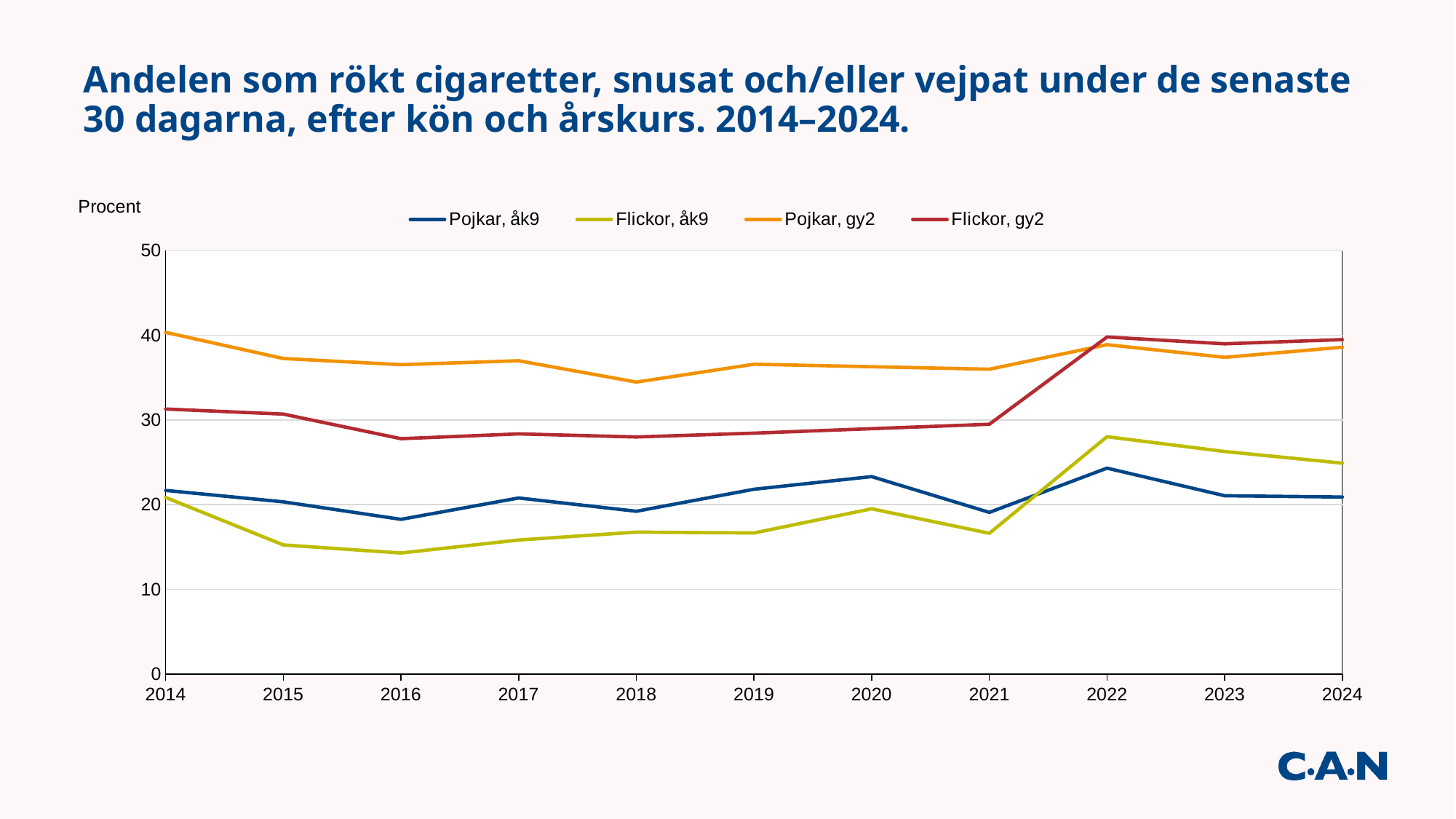
In 2024, which is higher: Pojkar, åk9 or Flickor, åk9? Flickor, åk9 In which year does the Pojkar, gy2 series reach its lowest value? 2018 Is the value for Pojkar, åk9 in 2022 greater or less than 20? greater How many series does the legend list? 4 Which series has the highest value in 2014? Pojkar, gy2 What kind of chart is shown on the slide? line chart How many years are plotted along the x axis? 11 In which year does the Flickor, åk9 series reach its highest value? 2022 Is the value for Flickor, åk9 in 2022 greater or less than 30? less Which series has the lowest value in 2016? Flickor, åk9 Does the Flickor, gy2 series rise or fall between 2021 and 2022? rise Is the value for Flickor, åk9 in 2016 greater or less than 20? less